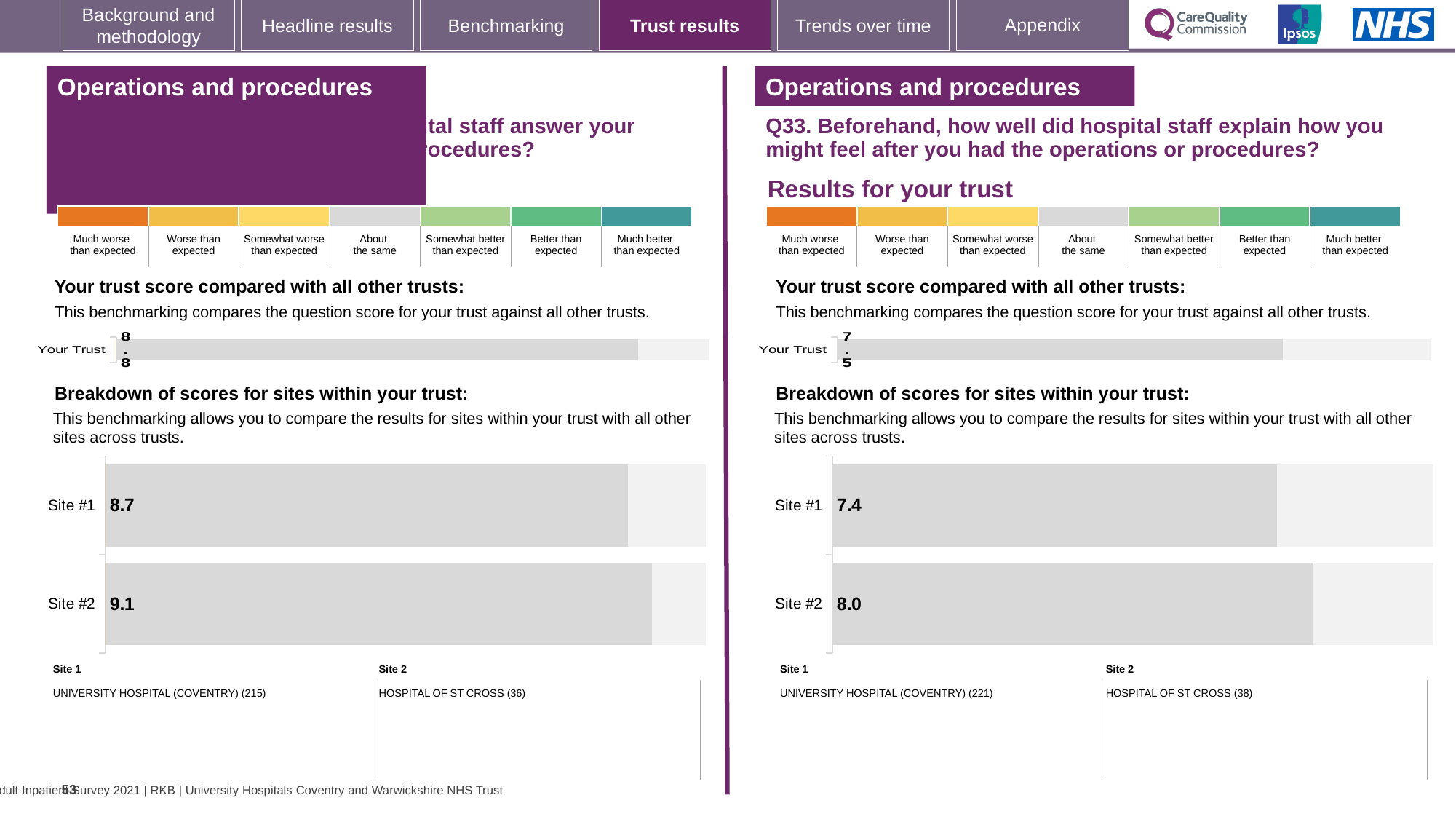
In the Q33 site breakdown chart, what is the difference between the Site #2 and Site #1 scores? 0.6 On the left-hand side of the slide, what is the score shown for Your Trust? 8.8 In the left-hand breakdown of scores for sites within your trust, what is the score for Site #2? 9.1 In the Q33 site breakdown chart, which site has the lower score? Site #1 On the right-hand side of the slide (Q33), what is the score shown for Your Trust? 7.5 What type of chart is used for the breakdown of scores for sites within your trust on the right-hand side? Bar chart How many sites are shown in the Q33 breakdown of scores for sites within your trust? 2 In the left-hand site breakdown chart, what is the difference between the Site #2 and Site #1 scores? 0.4 In the left-hand site breakdown chart, which site has the higher score? Site #2 In the left-hand breakdown of scores for sites within your trust, what is the score for Site #1? 8.7 In the Q33 breakdown of scores for sites within your trust, what is the score for Site #2? 8.0 In the Q33 breakdown of scores for sites within your trust, what is the score for Site #1? 7.4